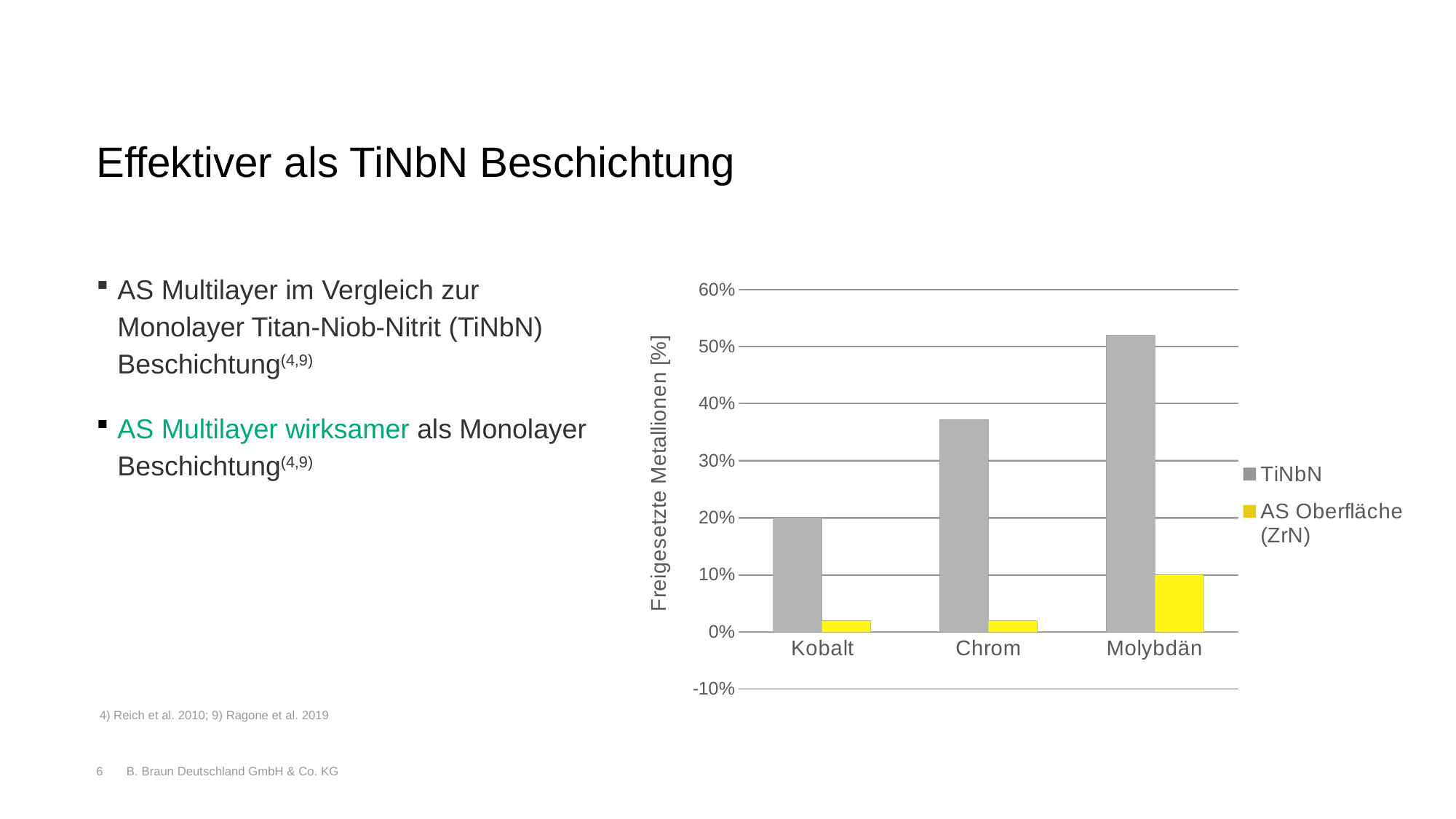
Is the TiNbN value for Chrom greater or less than 40%? less Which category has the lowest TiNbN value? Kobalt Which category has the highest TiNbN value? Molybdän What kind of chart is shown on the slide? bar chart Do the TiNbN values rise or fall from Kobalt to Molybdän along the x axis? rise Is the AS Oberfläche (ZrN) value for Kobalt greater or less than 10%? less Is the TiNbN value for Molybdän greater or less than 50%? greater How many categories are shown on the x axis? 3 Which category has the highest AS Oberfläche (ZrN) value? Molybdän For Chrom, which series has the larger value, TiNbN or AS Oberfläche (ZrN)? TiNbN How many series does the legend list? 2 What is the label of the y axis? Freigesetzte Metallionen [%]